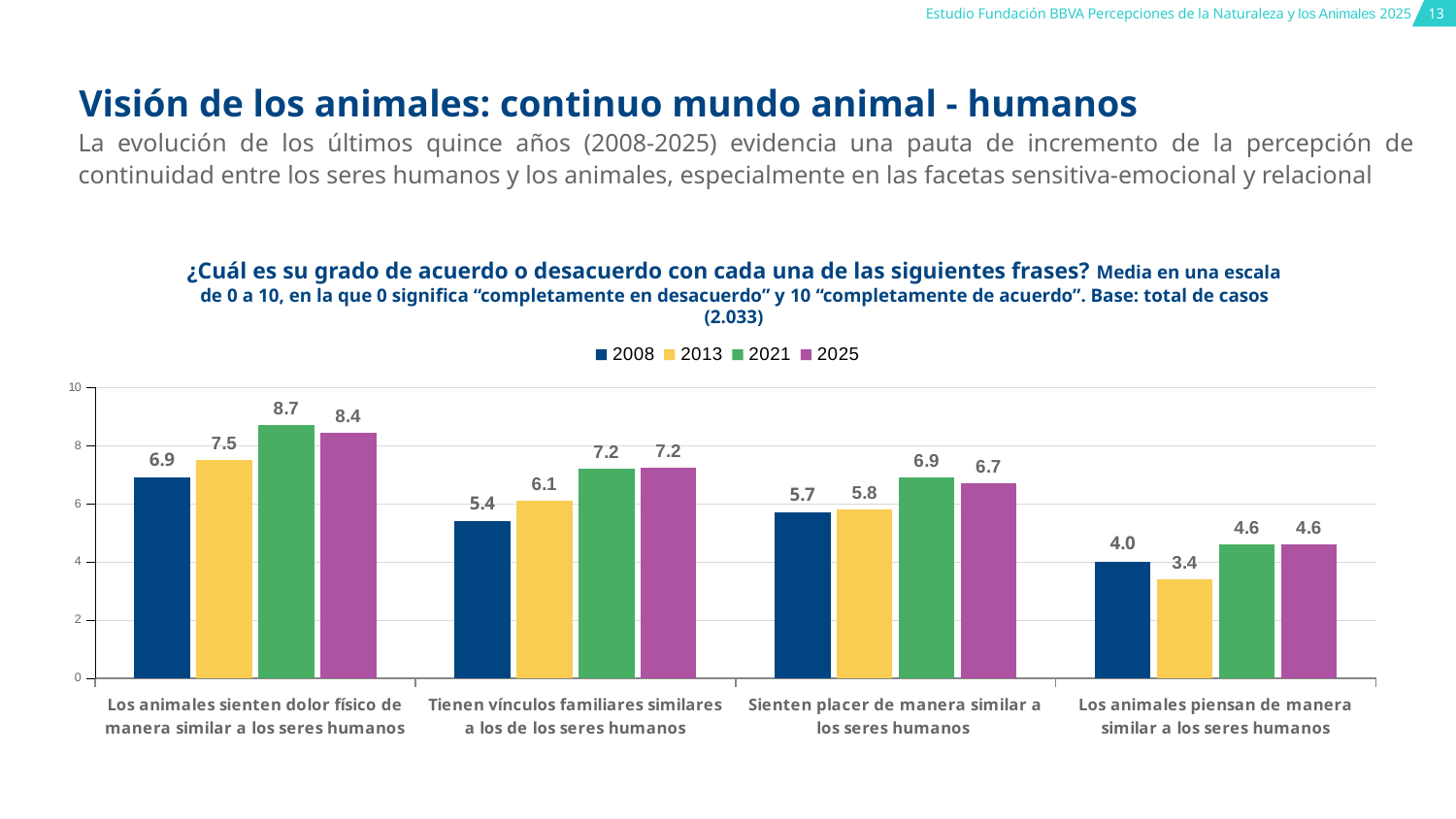
What is the difference between the 2013 and 2008 values for "Los animales piensan de manera similar a los seres humanos"? 0.6 What is the difference between the 2021 and 2008 values for "Tienen vínculos familiares similares a los de los seres humanos"? 1.8 Which category has the highest 2021 value? Los animales sienten dolor físico de manera similar a los seres humanos Which category has the lowest 2008 value? Los animales piensan de manera similar a los seres humanos How many series does the legend list? 4 What kind of chart is shown on the slide? Bar chart What is the 2025 value for "Los animales sienten dolor físico de manera similar a los seres humanos"? 8.4 What is the 2008 value for "Tienen vínculos familiares similares a los de los seres humanos"? 5.4 How many categories are shown on the x axis? 4 Which year does the legend show in yellow? 2013 For "Sienten placer de manera similar a los seres humanos", which is larger: the 2021 value or the 2025 value? 2021 What is the 2013 value for "Los animales piensan de manera similar a los seres humanos"? 3.4